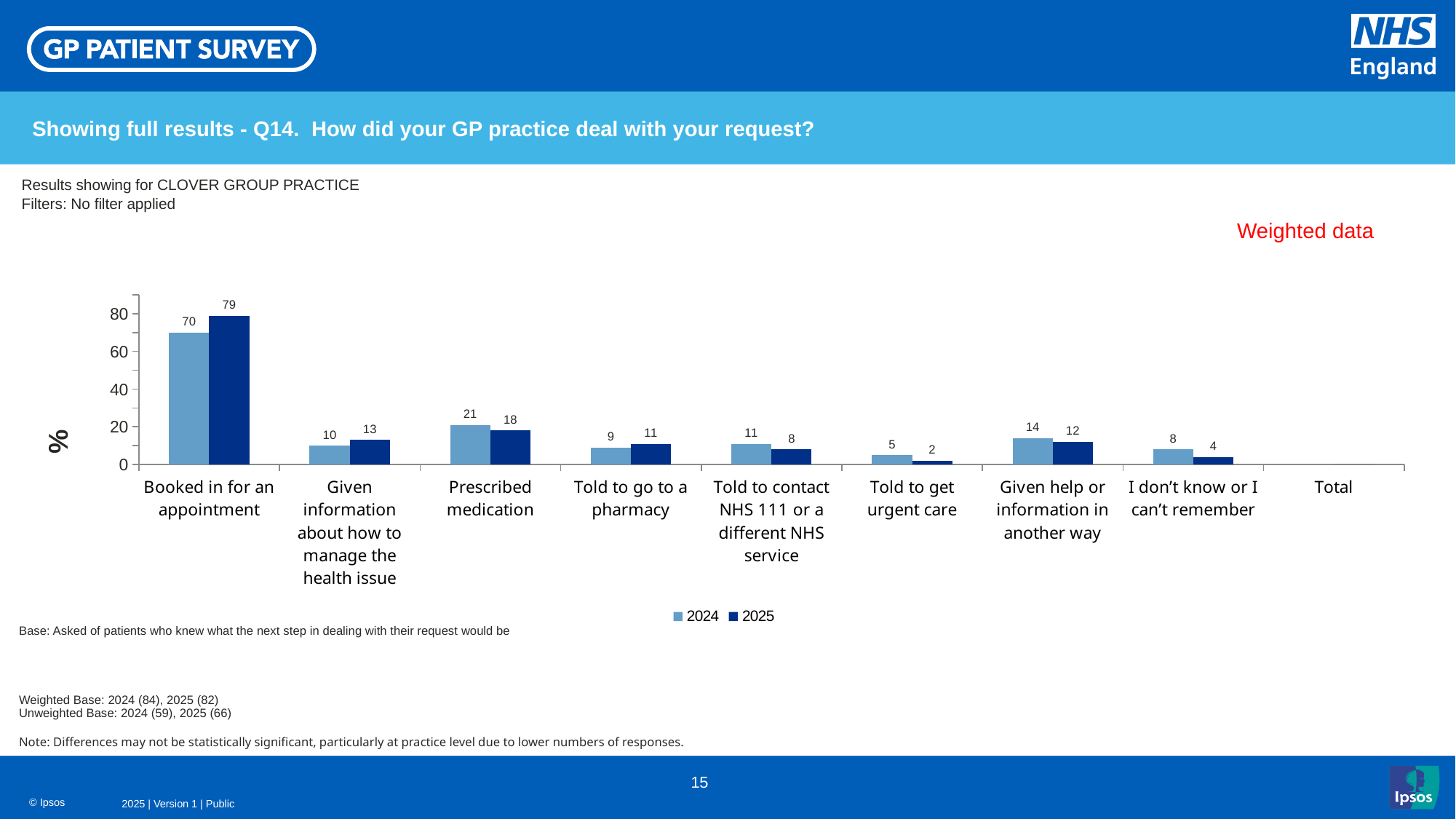
Which category has the lowest 2025 value? Told to get urgent care Which is larger for 'Given help or information in another way': the 2024 value or the 2025 value? 2024 How many series does the legend list? 2 What is the 2025 value for 'Booked in for an appointment'? 79 Is the 2024 value for 'Booked in for an appointment' greater or less than 60? greater What is the 2025 value for 'Told to get urgent care'? 2 What kind of chart is shown on the slide? Bar chart What label is shown on the vertical axis of the chart? % Which category has the highest 2024 value? Booked in for an appointment What is the difference between the 2025 and 2024 values for 'Booked in for an appointment'? 9 What is the 2024 value for 'Prescribed medication'? 21 What is the 2025 value for 'I don't know or I can't remember'? 4